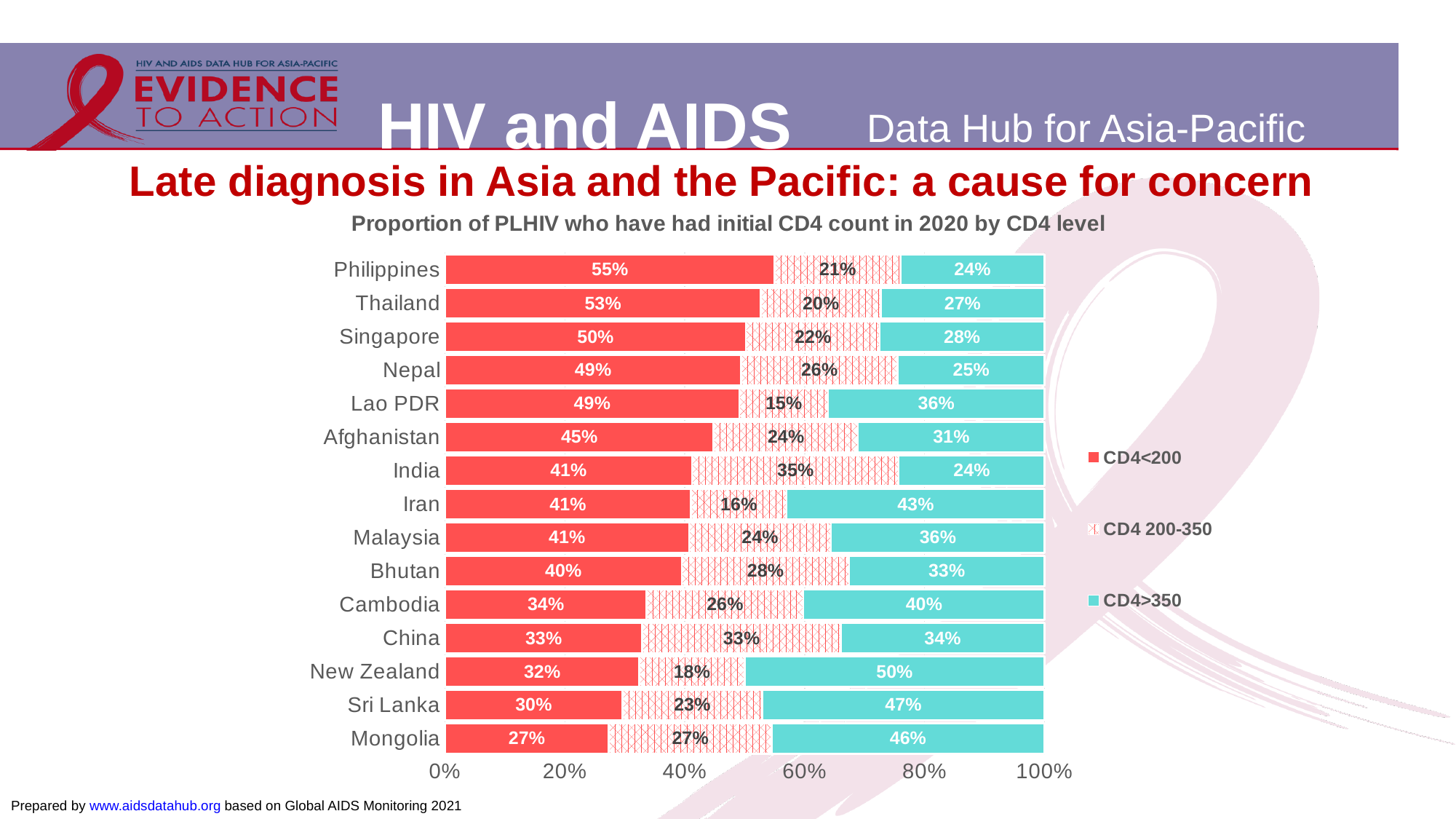
What is the total of the three segments for Mongolia? 100% Which country has the highest CD4>350 proportion? New Zealand How many countries are shown in the chart? 15 How many series does the legend list? 3 What is the CD4 200-350 value for India? 35% What is the CD4>350 value for Iran? 43% Which country has the highest CD4<200 proportion? Philippines What percentage of PLHIV in the Philippines had an initial CD4 count below 200? 55% What type of chart is shown on the slide? Stacked bar chart Which is larger: the CD4>350 value for Lao PDR or for Cambodia? Cambodia Which country has the lowest CD4<200 proportion? Mongolia What is the difference between the CD4<200 values for Thailand and Sri Lanka? 23 percentage points